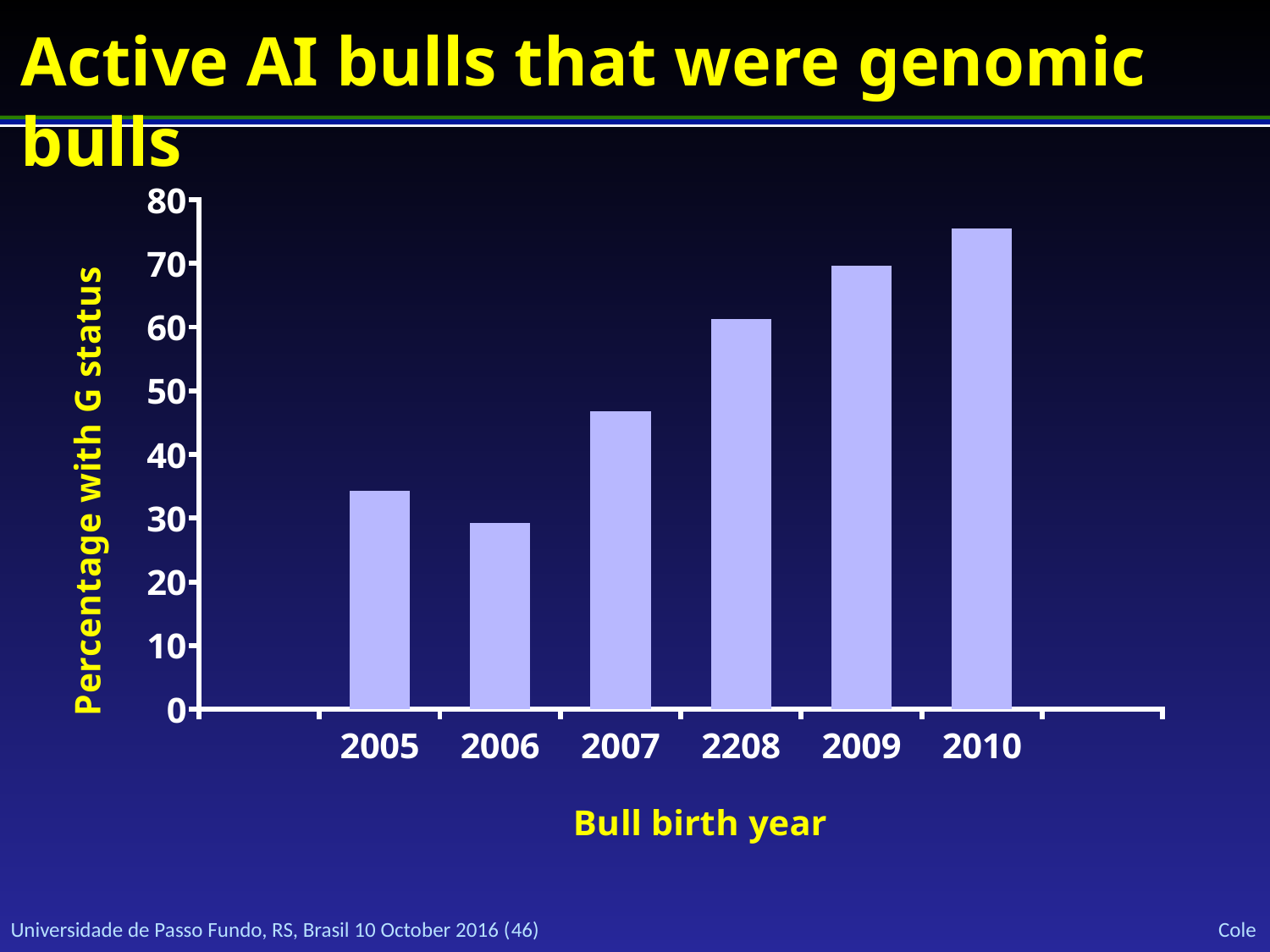
Is the percentage with G status for 2007 greater or less than 50? less Which bull birth year has the lowest percentage with G status? 2006 Is the percentage with G status for 2006 greater or less than 20? greater How many bull birth years are plotted on the chart? 6 Is the percentage with G status for 2005 greater or less than 30? greater Which has a higher percentage with G status, 2009 or 2007? 2009 Which has a higher percentage with G status, 2005 or 2006? 2005 What kind of chart is shown on the slide? bar chart What is the label of the x axis? Bull birth year Which bull birth year has the highest percentage with G status? 2010 From 2006 to 2010, do the percentages with G status rise or fall? rise